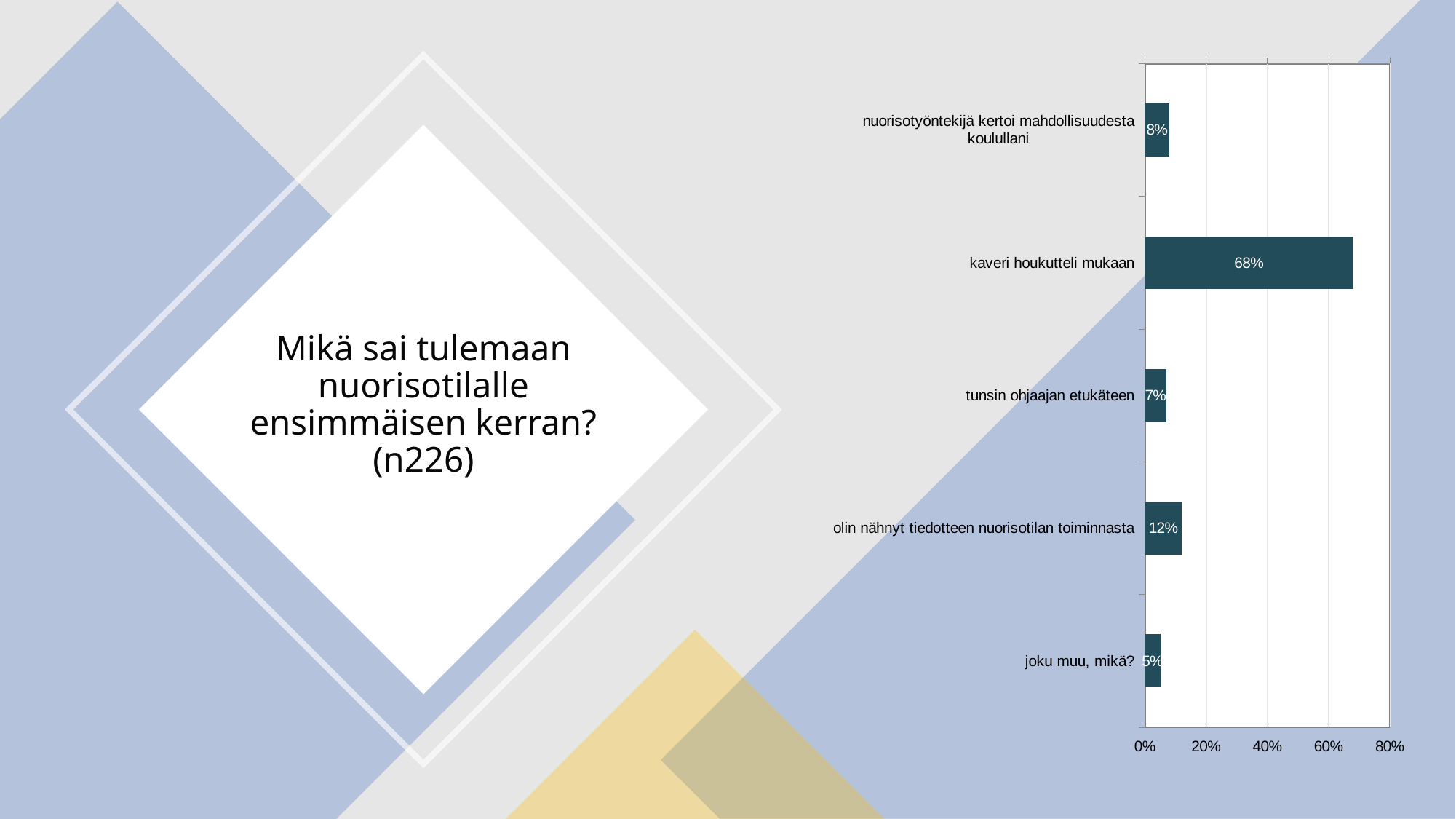
What is the difference between the values for "kaveri houkutteli mukaan" and "olin nähnyt tiedotteen nuorisotilan toiminnasta"? 56% Which category has the highest value? kaveri houkutteli mukaan What is the value for "kaveri houkutteli mukaan"? 68% What is the value for "joku muu, mikä?"? 5% Is the value for "kaveri houkutteli mukaan" greater or less than 60%? greater How many categories are shown in the chart? 5 What is the value for "nuorisotyöntekijä kertoi mahdollisuudesta koulullani"? 8% What kind of chart is shown on the slide? bar chart What is the value for "tunsin ohjaajan etukäteen"? 7% Which is larger, the value for "olin nähnyt tiedotteen nuorisotilan toiminnasta" or the value for "nuorisotyöntekijä kertoi mahdollisuudesta koulullani"? olin nähnyt tiedotteen nuorisotilan toiminnasta What is the value for "olin nähnyt tiedotteen nuorisotilan toiminnasta"? 12% Which category has the lowest value? joku muu, mikä?